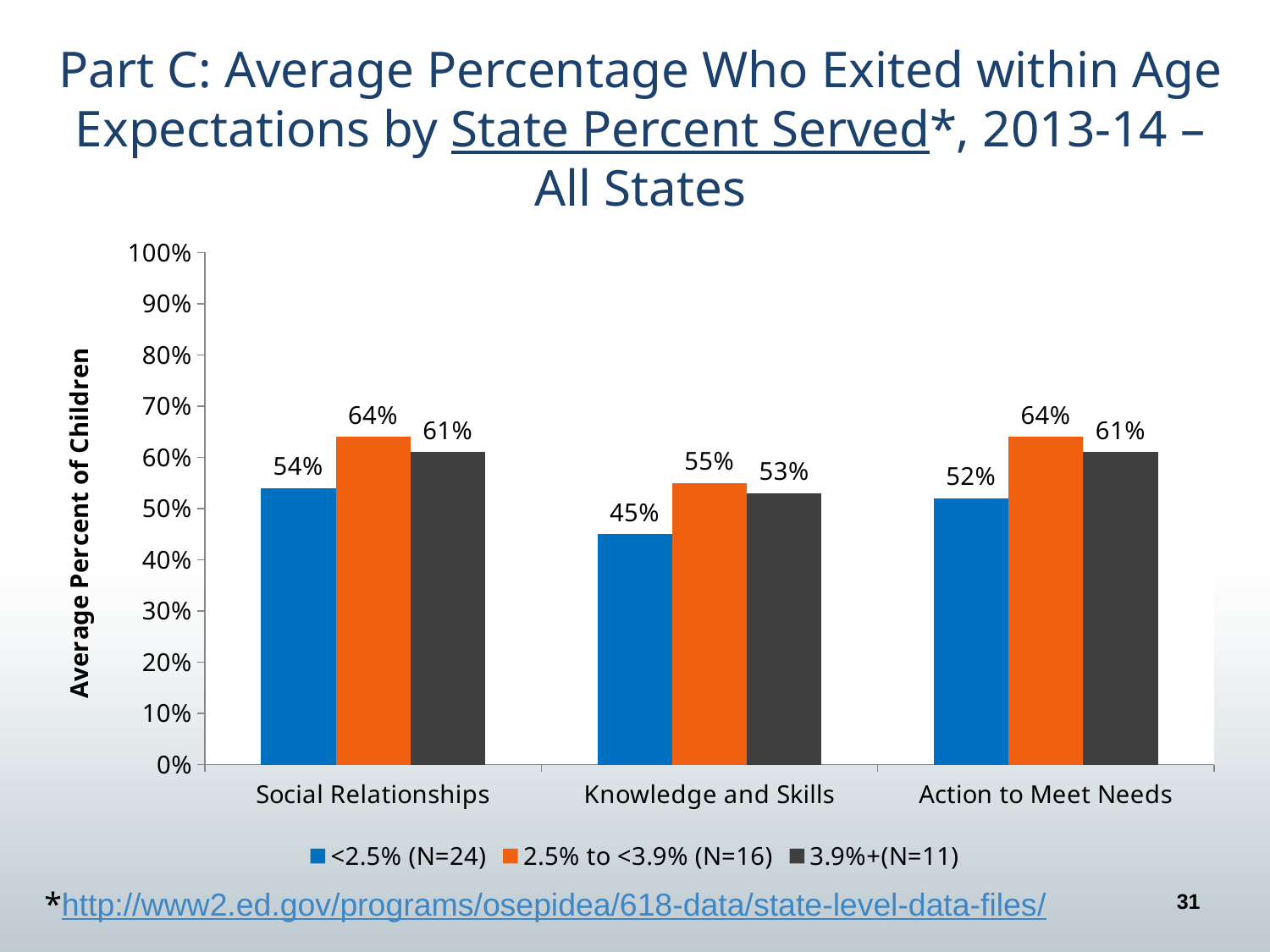
How many categories are shown on the x axis? 3 What is the value for the <2.5% (N=24) series in the Knowledge and Skills category? 45% Which series has the highest value in the Knowledge and Skills category? 2.5% to <3.9% (N=16) What is the label of the y axis? Average Percent of Children What kind of chart is shown on the slide? bar chart What is the value for the 2.5% to <3.9% (N=16) series in the Action to Meet Needs category? 64% What is the difference between the 2.5% to <3.9% (N=16) and <2.5% (N=24) values in the Social Relationships category? 10% How many series does the legend list? 3 Which is larger: the 3.9%+(N=11) value for Knowledge and Skills or the <2.5% (N=24) value for Social Relationships? <2.5% (N=24) value for Social Relationships Which category has the lowest value for the <2.5% (N=24) series? Knowledge and Skills Is the value for the <2.5% (N=24) series in Action to Meet Needs greater or less than 60%? less What is the value for the 3.9%+(N=11) series in the Social Relationships category? 61%